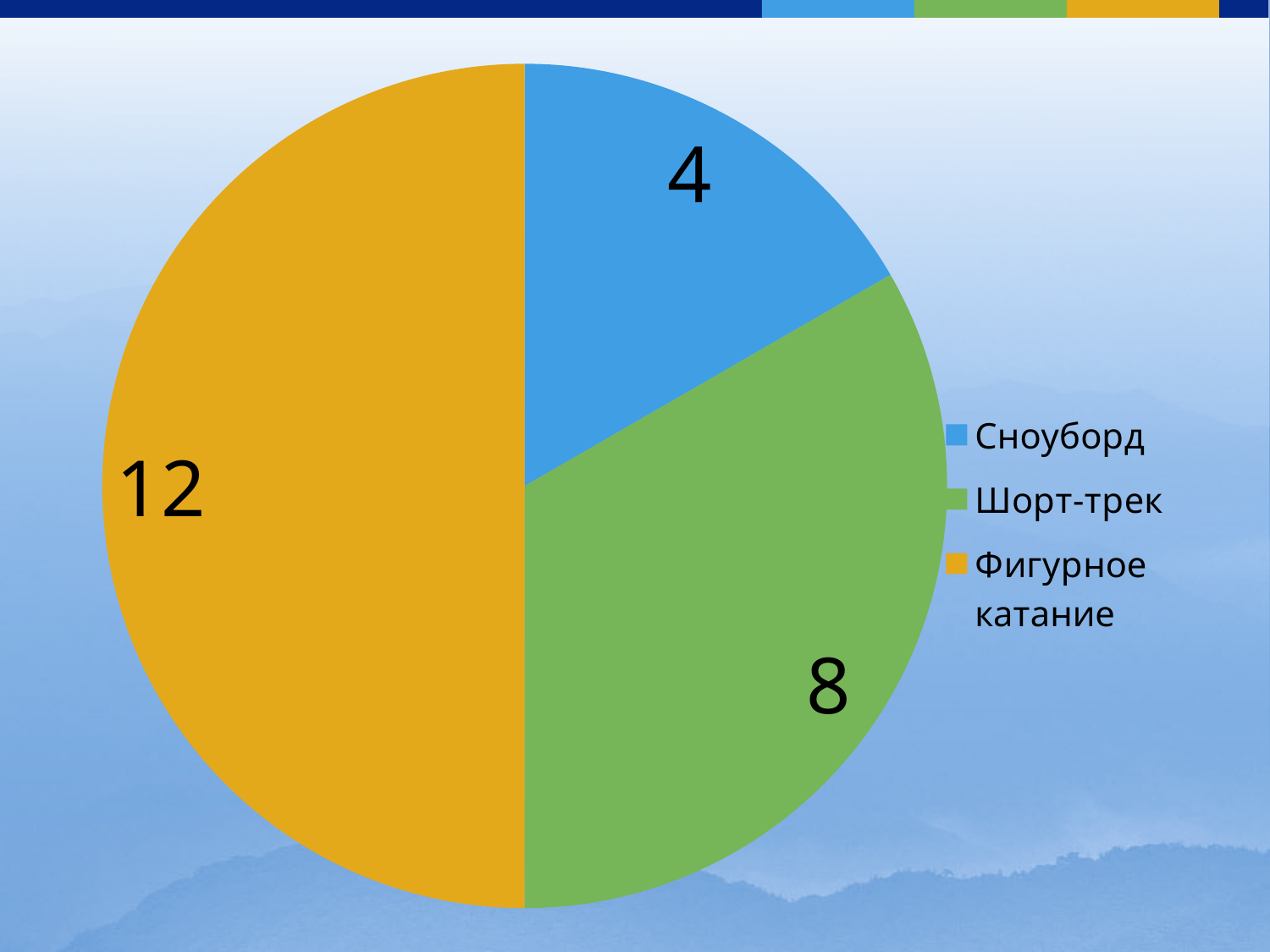
What colour is the slice for Шорт-трек? green What is the value for Сноуборд? 4 Which category has the smallest slice? Сноуборд Which category has the largest slice? Фигурное катание What share of the pie does Фигурное катание represent? 50% What kind of chart is shown on the slide? pie chart What is the difference between the values for Фигурное катание and Сноуборд? 8 What is the value for Фигурное катание? 12 What is the value for Шорт-трек? 8 What is the total of all slices in the pie chart? 24 How many categories does the pie chart have? 3 Which is larger, the value for Шорт-трек or the value for Сноуборд? Шорт-трек